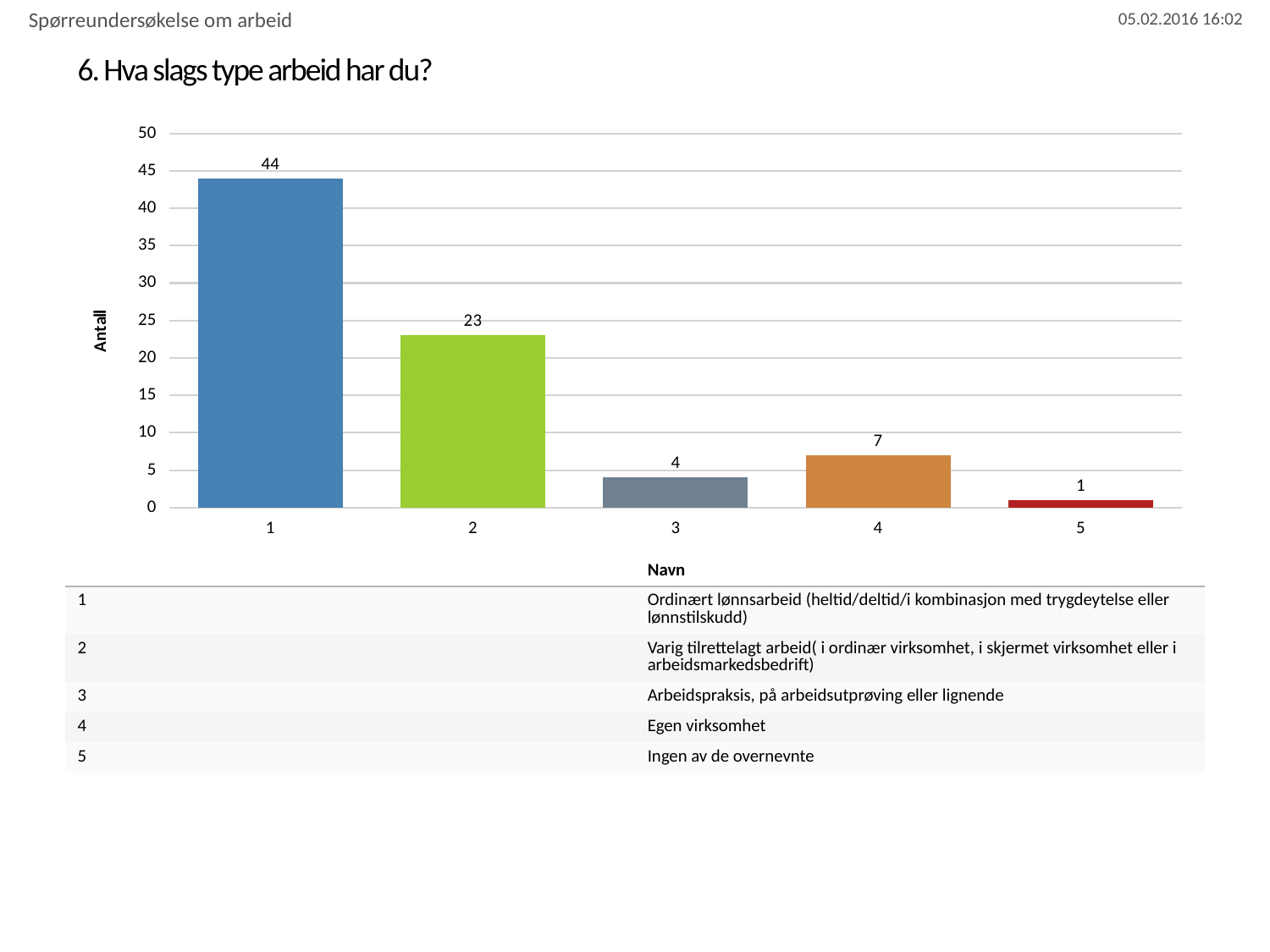
What is the value for category 1 (Ordinært lønnsarbeid)? 44 Which category has the highest value? 1 How many categories are shown in the chart? 5 What is the value for category 4 (Egen virksomhet)? 7 Which category has the lowest value? 5 What is the value for category 2 (Varig tilrettelagt arbeid)? 23 Is the value for category 2 greater or less than 20? greater What is the difference between the values for category 1 and category 2? 21 Which is larger, the value for category 3 or category 4? category 4 What is the label of the y axis? Antall What kind of chart is shown on the slide? bar chart What is the value for category 5 (Ingen av de overnevnte)? 1